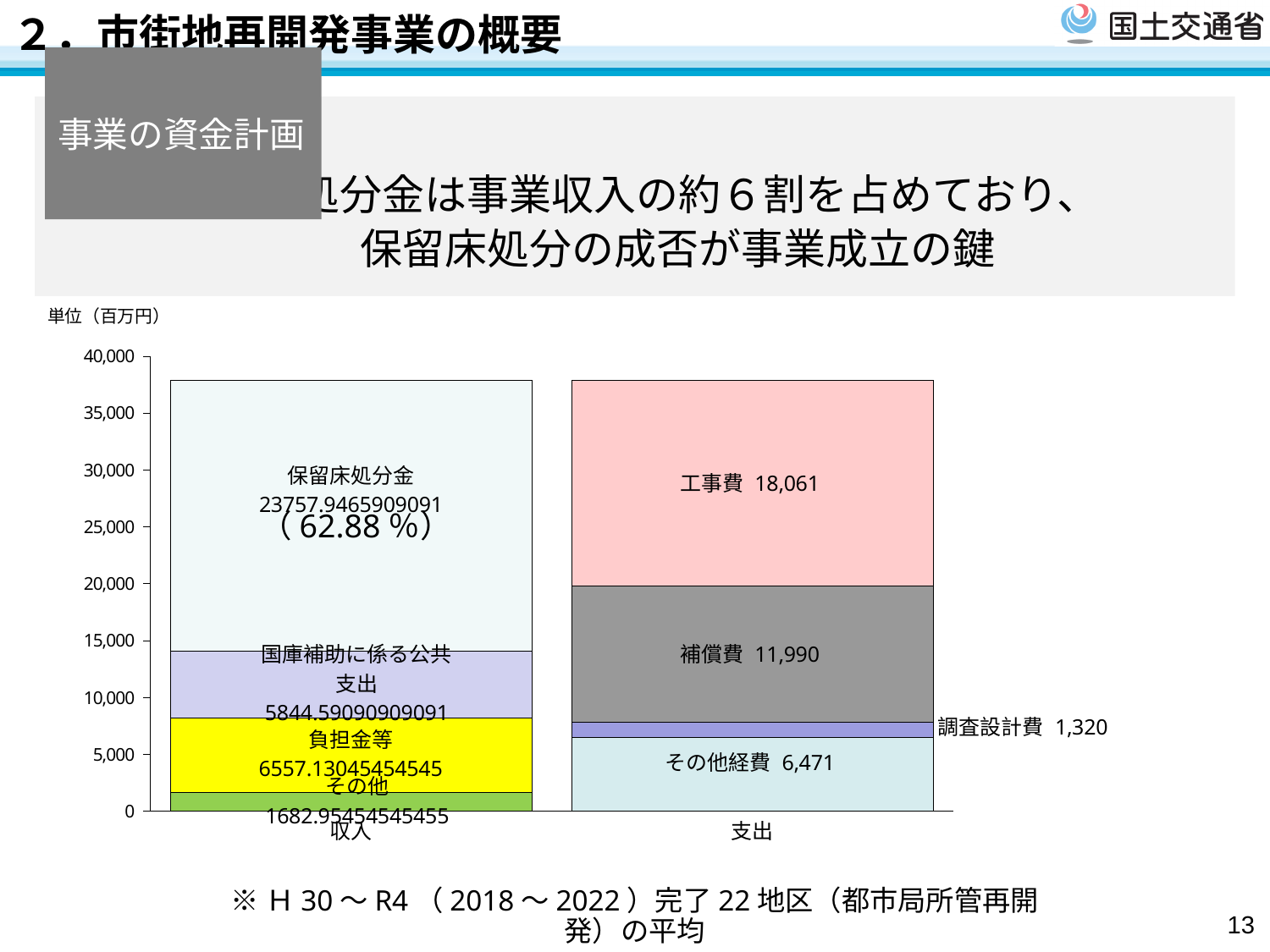
What is the value of 調査設計費 in the 支出 bar? 1,320 Which segment of the 支出 bar is the smallest? 調査設計費 Which segment of the 支出 bar is the largest? 工事費 What unit is stated for the chart values? 百万円 What is the value of 補償費 in the 支出 bar? 11,990 Which is larger in the 支出 bar, 補償費 or その他経費? 補償費 What is the value of その他経費 in the 支出 bar? 6,471 What is the total of the 支出 bar? 37,842 What is the value of 工事費 in the 支出 bar? 18,061 What percentage share is shown for 保留床処分金 in the 収入 bar? 62.88% How many bars (categories) are shown on the x axis? 2 What is the difference between 工事費 and 補償費 in the 支出 bar? 6,071